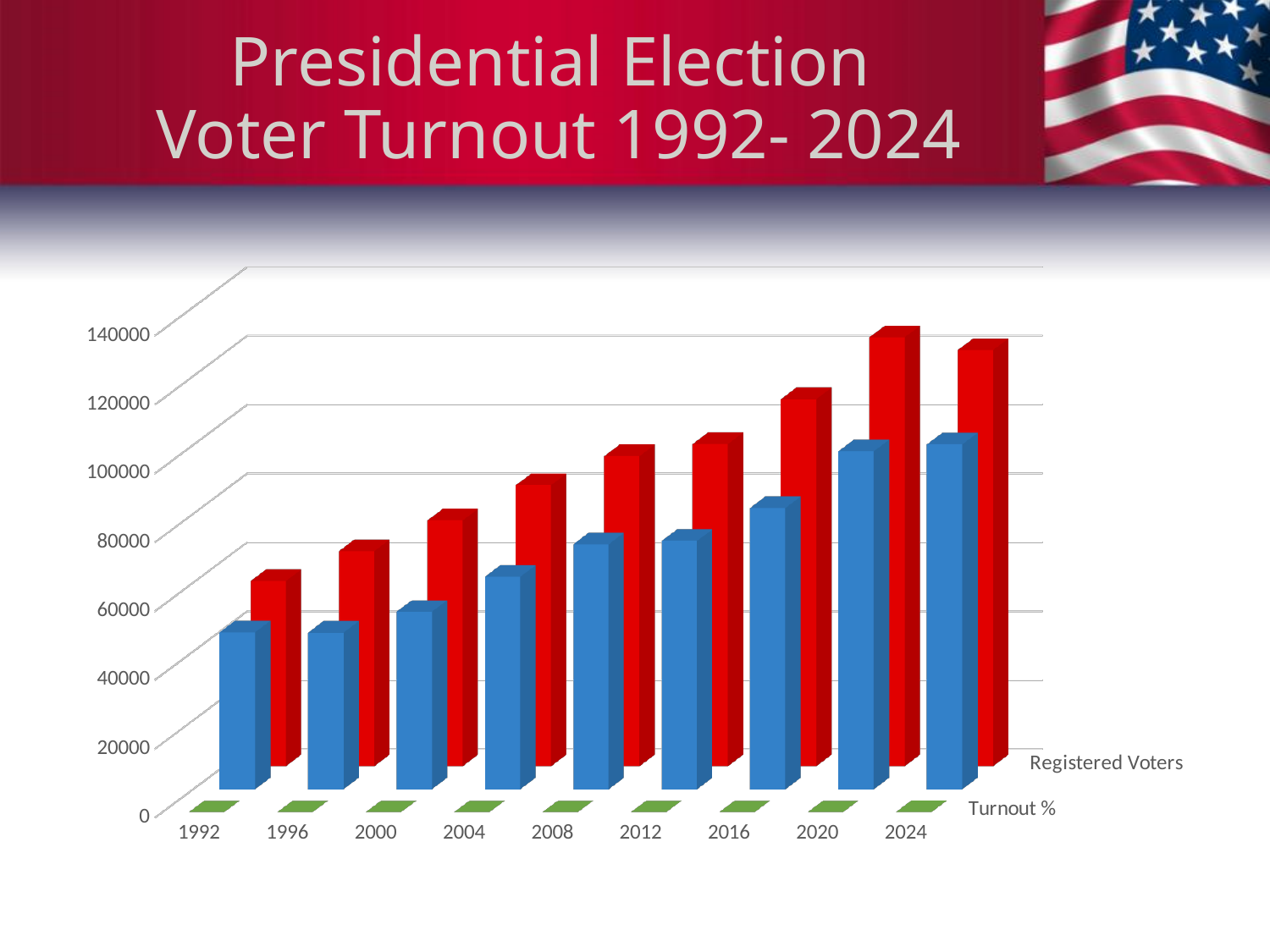
What kind of chart is shown on the slide? Bar chart How many election years are shown on the x axis of the chart? 9 Which year has the highest Registered Voters value? 2020 Which series is shown with red bars? Registered Voters Which is larger, the Registered Voters value for 2020 or for 2024? 2020 Is the value of the blue bar for 1992 greater or less than 60000? less Do the Registered Voters values generally rise or fall from 1992 to 2020? Rise Is the Registered Voters value for 2020 greater or less than 120000? greater Which year has the lowest Registered Voters value? 1992 Is the Registered Voters value for 1992 greater or less than 80000? less